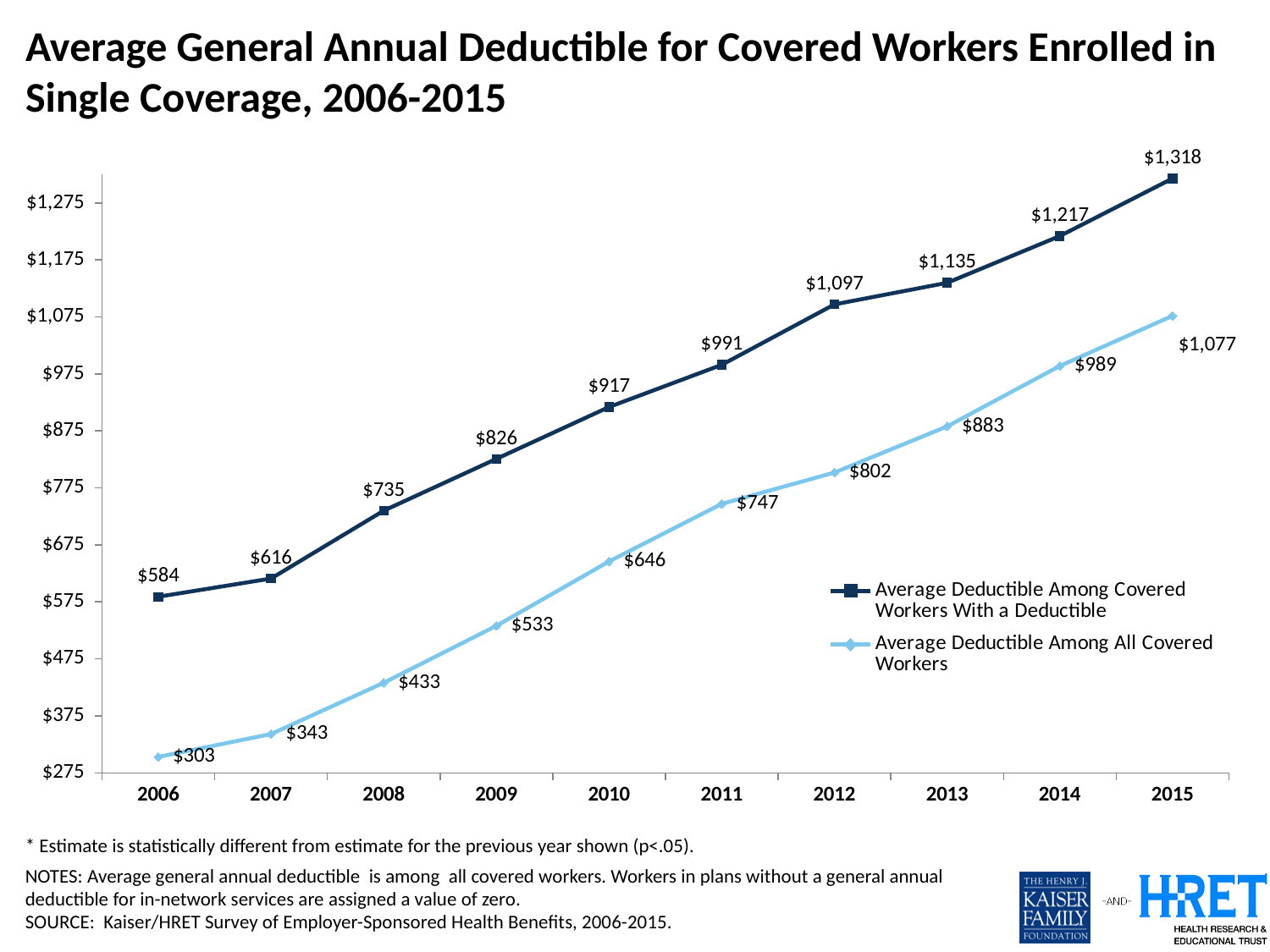
In which year is the average deductible among covered workers with a deductible highest? 2015 How many series does the legend list? 2 What kind of chart is shown on the slide? Line chart What is the average deductible among all covered workers in 2015? $1,077 How many years are shown on the x axis? 10 What is the average deductible among all covered workers in 2006? $303 Do the values for average deductible among all covered workers rise or fall from 2006 to 2015? Rise What is the average deductible among covered workers with a deductible in 2010? $917 Which is larger in 2012: the average deductible among covered workers with a deductible or among all covered workers? Average Deductible Among Covered Workers With a Deductible How much did the average deductible among covered workers with a deductible increase from 2006 to 2015? $734 In which year is the average deductible among all covered workers lowest? 2006 What is the difference between the two series' values in 2015? $241